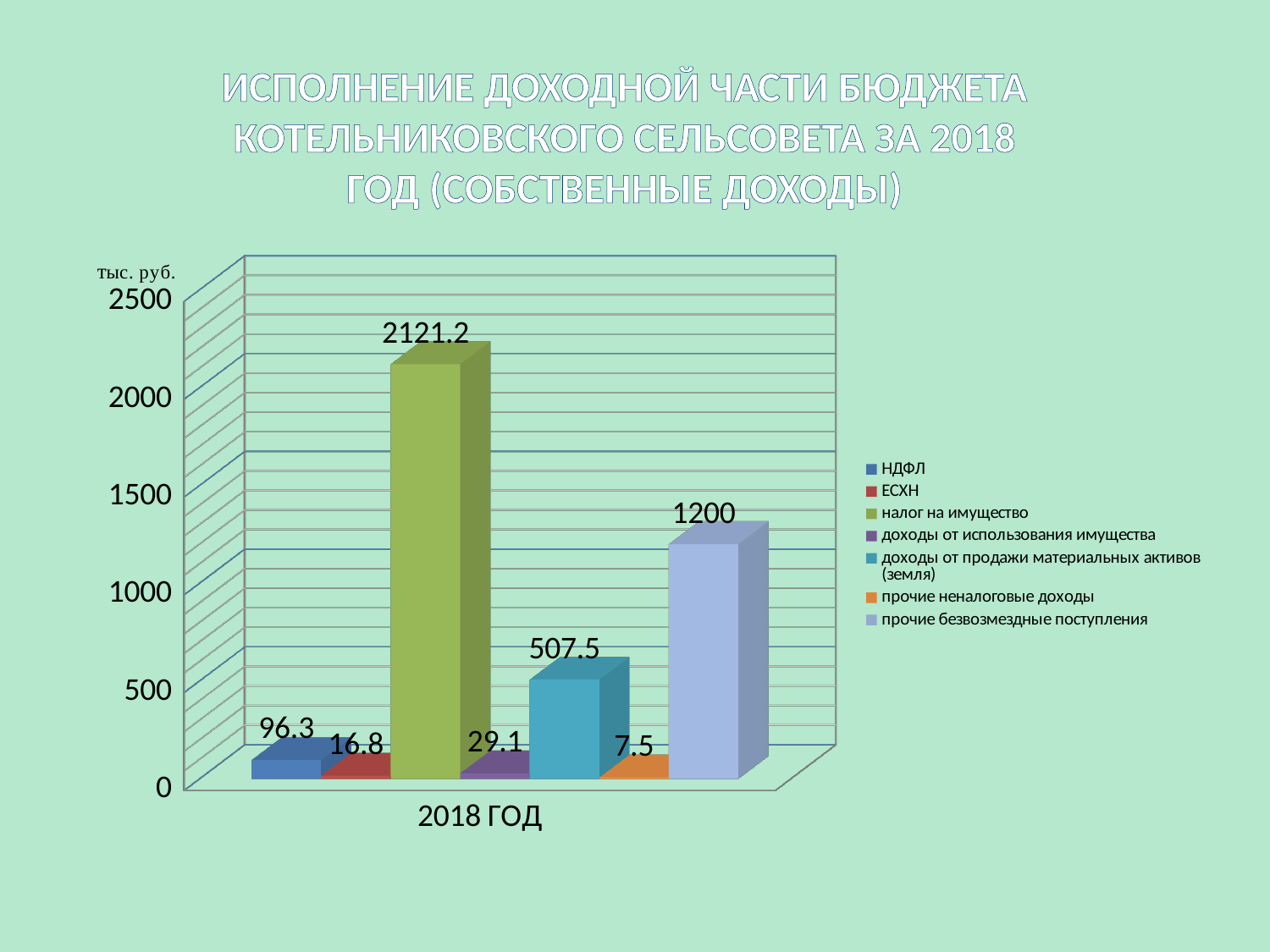
What is the value for налог на имущество in 2018? 2121.2 Which series has the highest value on the chart? налог на имущество What is the value for НДФЛ in 2018? 96.3 Which series has the lowest value on the chart? прочие неналоговые доходы What is the value for прочие безвозмездные поступления in 2018? 1200 What kind of chart is shown on the slide? bar chart What unit is shown on the vertical axis of the chart? тыс. руб. How many series does the legend list? 7 Which is larger: ЕСХН or доходы от использования имущества? доходы от использования имущества What is the difference between налог на имущество and прочие безвозмездные поступления? 921.2 What is the value for доходы от продажи материальных активов (земля)? 507.5 Is the value for доходы от продажи материальных активов (земля) greater or less than 1000? less